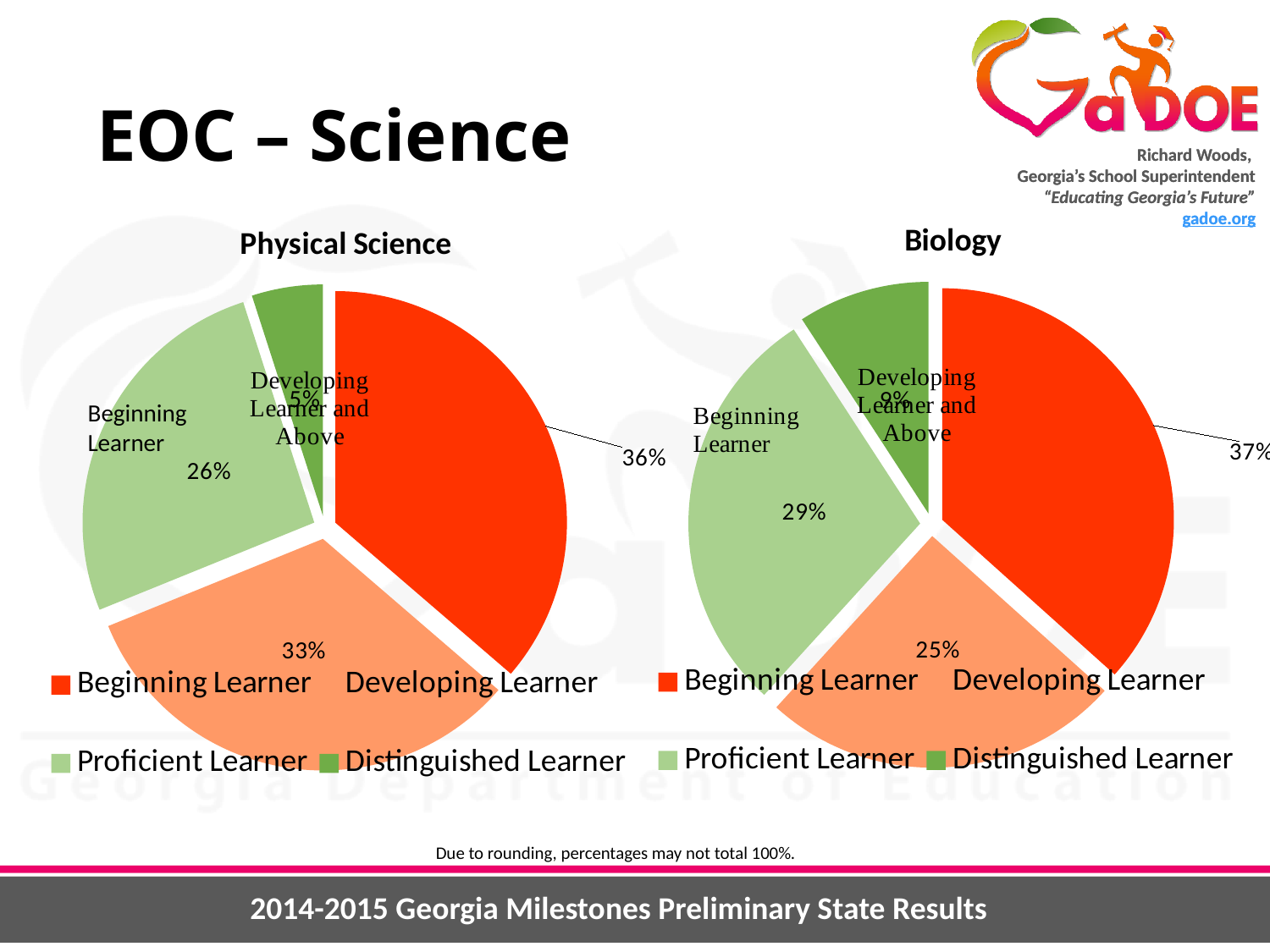
How many slices does the Biology pie chart have? 4 In the Biology chart, which category has the largest slice? Beginning Learner In the Physical Science chart, what colour is the Beginning Learner slice? Red In the Physical Science chart, what percentage is shown for the Distinguished Learner slice? 5% Which is larger: the Distinguished Learner share in Biology or in Physical Science? Biology In the Physical Science chart, which category has the smallest slice? Distinguished Learner In the Physical Science chart, what is the difference between the Developing Learner and Proficient Learner percentages? 7% What type of charts are shown on the slide? Pie charts In the Biology chart, what percentage is shown for the Developing Learner slice? 25% How many entries does the legend of the Physical Science chart list? 4 In the Physical Science chart, what percentage is shown for the Beginning Learner slice? 36% In the Biology chart, what percentage is shown for the Proficient Learner slice? 29%